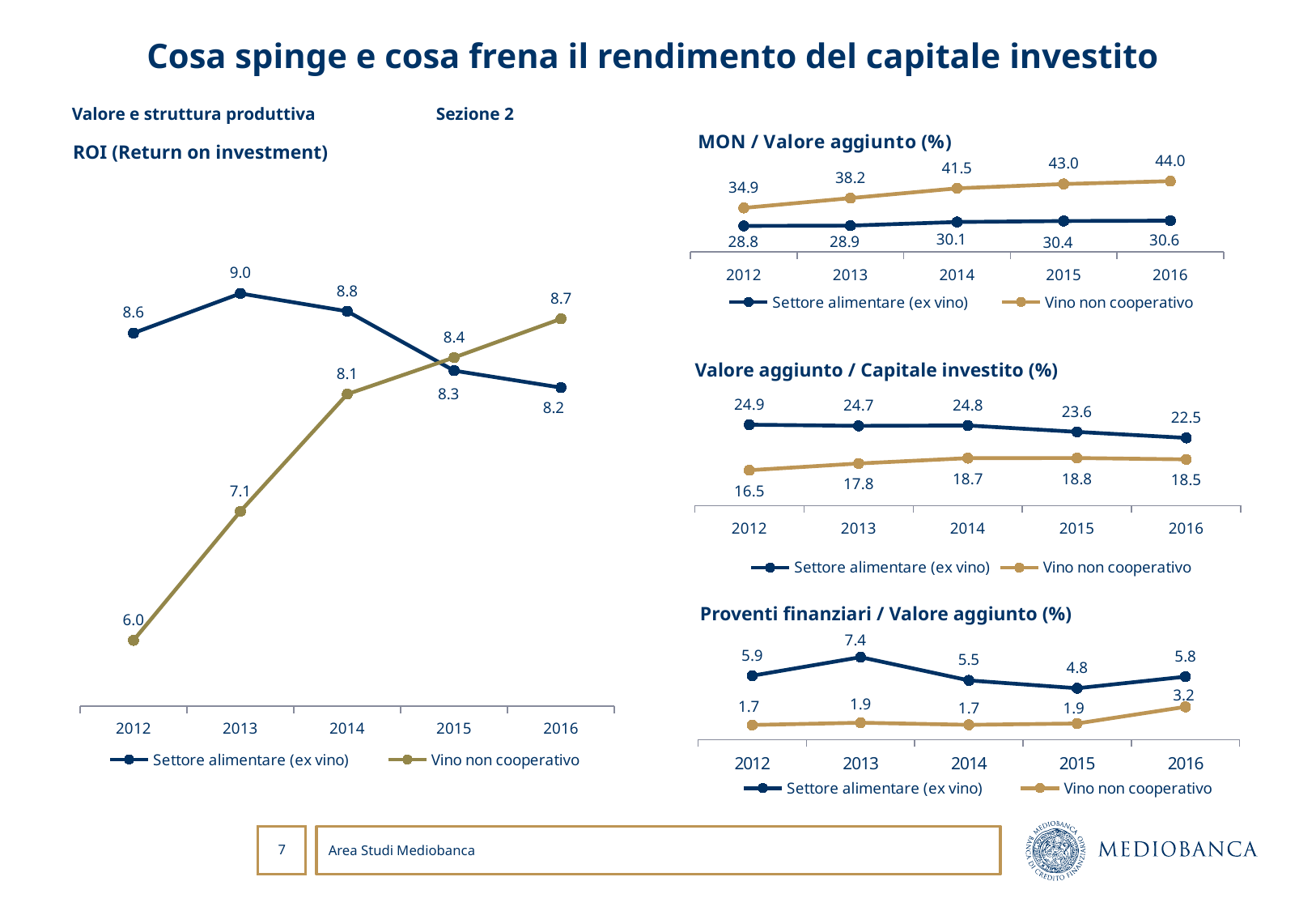
What kind of chart is the MON / Valore aggiunto (%) chart? line chart In the MON / Valore aggiunto (%) chart, what is the value for Vino non cooperativo in 2016? 44.0 In the MON / Valore aggiunto (%) chart, which series is higher in 2014, Settore alimentare (ex vino) or Vino non cooperativo? Vino non cooperativo In the Proventi finanziari / Valore aggiunto (%) chart, what is the value for Settore alimentare (ex vino) in 2013? 7.4 In the Proventi finanziari / Valore aggiunto (%) chart, what is the difference between Settore alimentare (ex vino) and Vino non cooperativo in 2016? 2.6 In the Valore aggiunto / Capitale investito (%) chart, what is the value for Settore alimentare (ex vino) in 2015? 23.6 In the Valore aggiunto / Capitale investito (%) chart, which year has the lowest value for Vino non cooperativo? 2012 In the ROI (Return on investment) chart, what is the difference between Vino non cooperativo and Settore alimentare (ex vino) in 2016? 0.5 How many years are shown on the x axis of the ROI (Return on investment) chart? 5 In the ROI (Return on investment) chart, which year has the highest value for Settore alimentare (ex vino)? 2013 In the ROI (Return on investment) chart, does the Vino non cooperativo series rise or fall from 2012 to 2016? rise In the ROI (Return on investment) chart, what is the value for Vino non cooperativo in 2012? 6.0